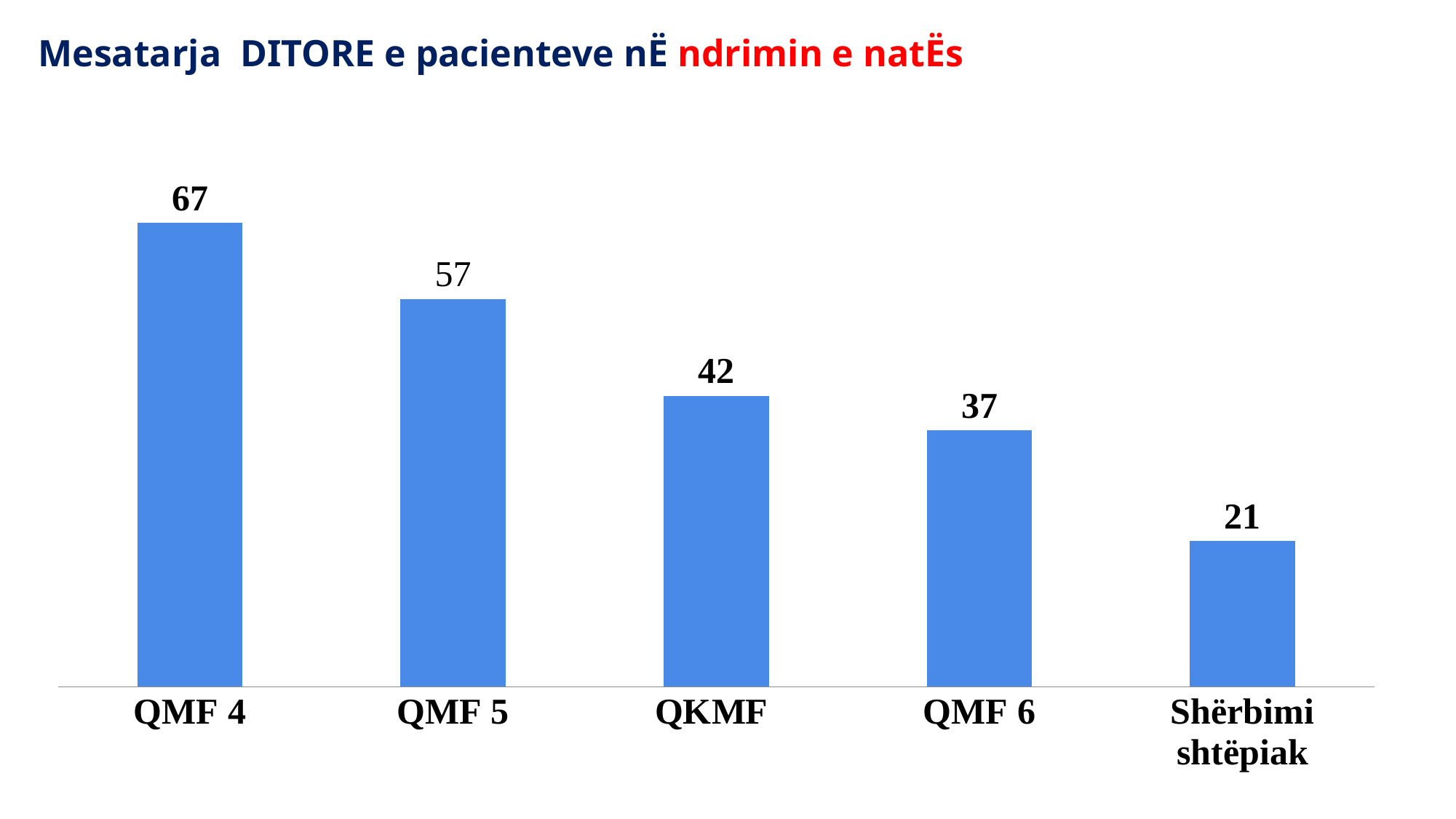
Which is larger, the value for QMF 5 or the value for QKMF? QMF 5 What is the value for QMF 4? 67 What is the difference between the values for QKMF and Shërbimi shtëpiak? 21 What kind of chart is shown on the slide? Bar chart What is the value for QKMF? 42 What is the value for Shërbimi shtëpiak? 21 How many categories are shown in the chart? 5 Which category has the highest value? QMF 4 What is the value for QMF 5? 57 Do the values rise or fall from left to right across the categories? Fall Which category has the lowest value? Shërbimi shtëpiak What is the difference between the values for QMF 4 and QMF 6? 30